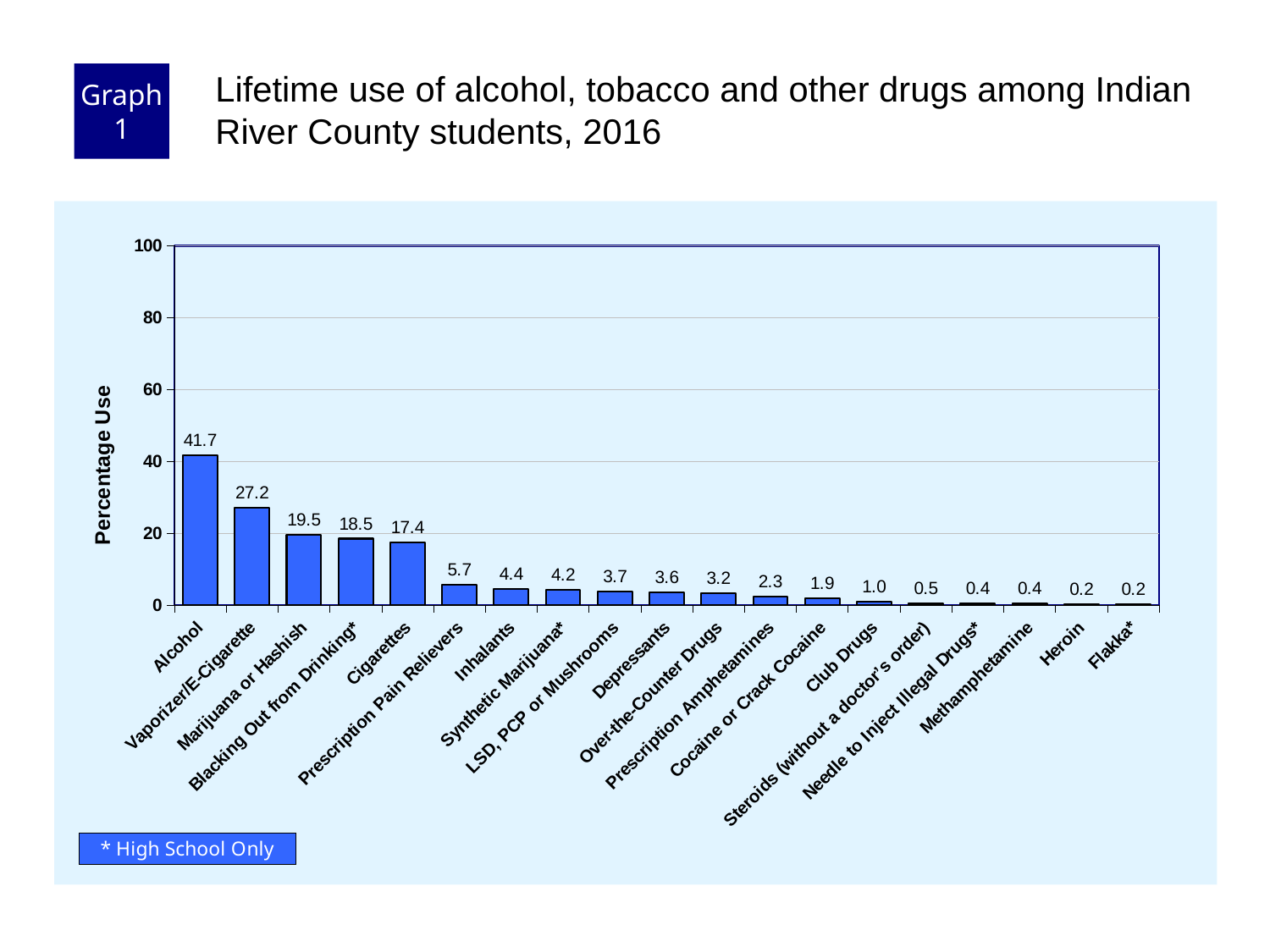
Which category has the highest percentage use? Alcohol How many categories are shown on the x axis? 19 What is the percentage use for Vaporizer/E-Cigarette? 27.2 What is the percentage use for Prescription Pain Relievers? 5.7 What is the difference in percentage use between Marijuana or Hashish and Blacking Out from Drinking*? 1.0 Which has a higher percentage use, Inhalants or Depressants? Inhalants What kind of chart is shown on the slide? Bar chart What is the percentage use for Club Drugs? 1.0 Is the value for Alcohol greater or less than 40? greater What is the difference in percentage use between Alcohol and Vaporizer/E-Cigarette? 14.5 What is the percentage use for Alcohol? 41.7 What is the percentage use for Cigarettes? 17.4